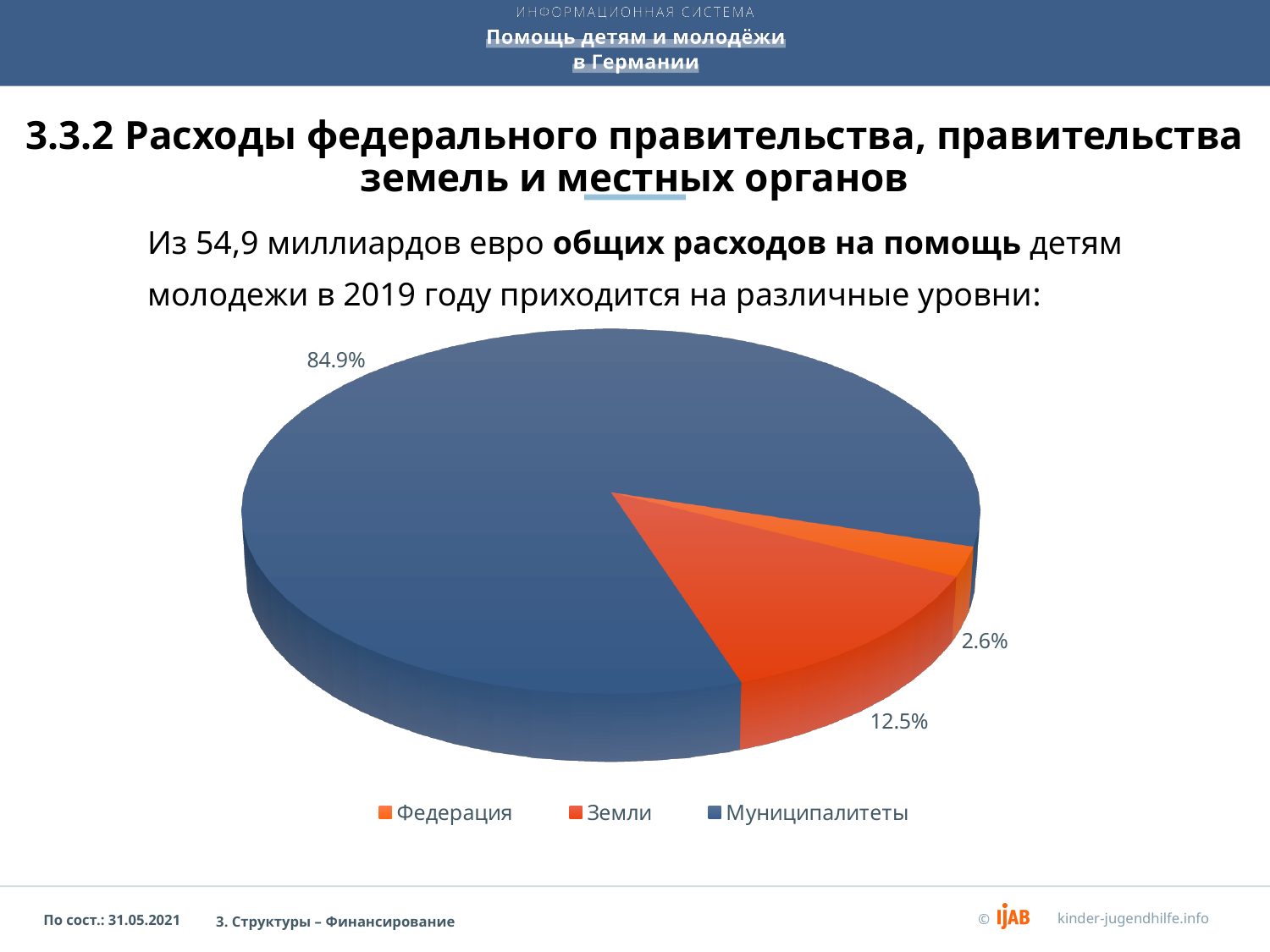
How many entries does the legend list? 3 What share of the pie does Федерация have? 2.6% Which is larger, the share for Земли or the share for Федерация? Земли Which legend entry is shown in blue? Муниципалитеты What share of the pie does Земли have? 12.5% Which category has the largest slice of the pie? Муниципалитеты What is the difference in percentage points between the Муниципалитеты slice and the Земли slice? 72.4 Which category has the smallest slice of the pie? Федерация What kind of chart is shown on the slide? pie chart What share of the pie does Муниципалитеты have? 84.9% What is the difference in percentage points between the Земли slice and the Федерация slice? 9.9 How many slices does the pie chart have? 3